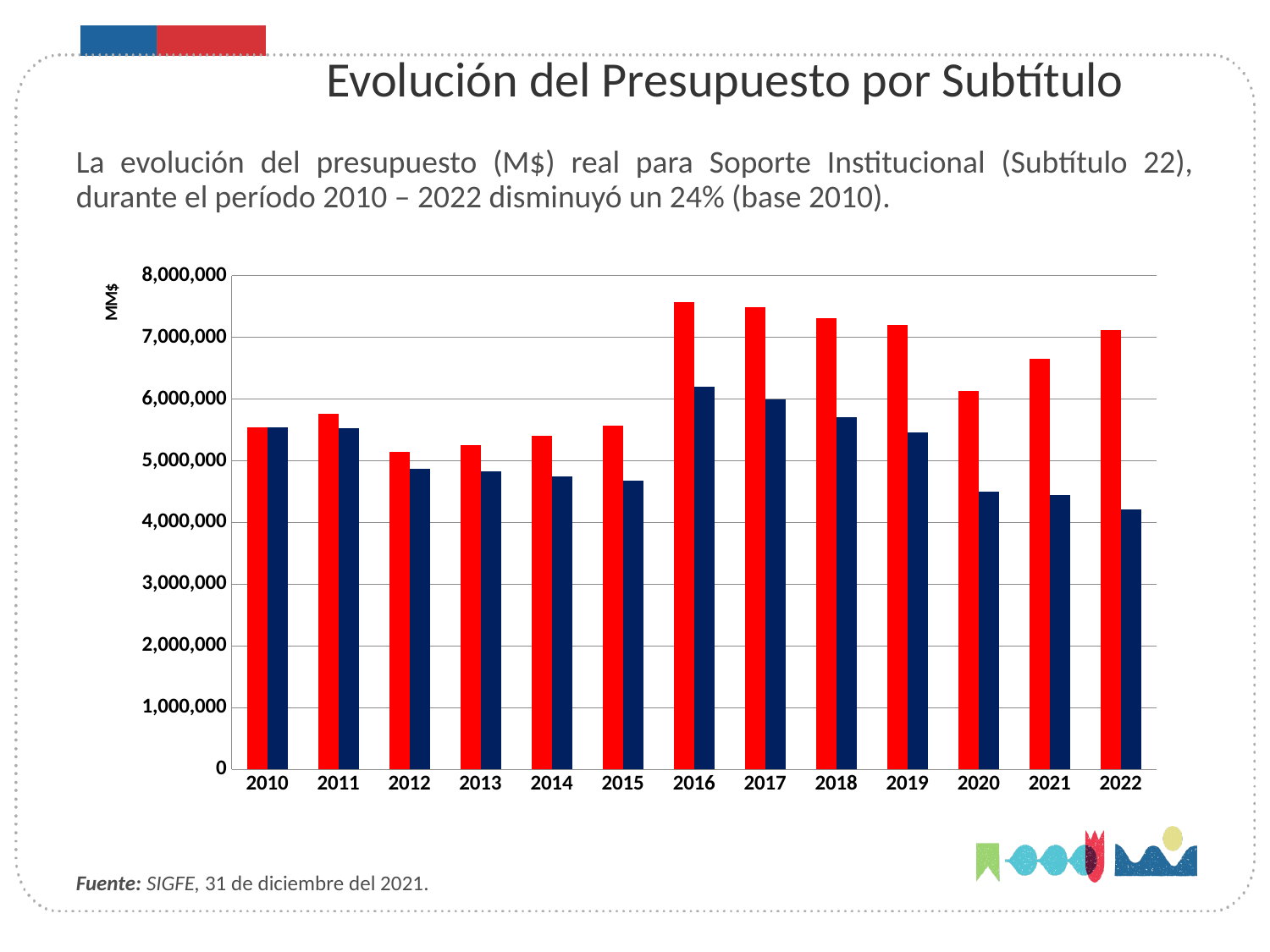
What is the label on the vertical axis of the chart? MM$ In which year is the dark blue bar the highest? 2016 Is the value of the dark blue bar for 2022 greater or less than 5,000,000? less Is the value of the dark blue bar for 2020 greater or less than 5,000,000? less What kind of chart is shown on the slide? bar chart How many years are shown on the x axis of the chart? 13 In which year is the dark blue bar the lowest? 2022 Is the value of the red bar for 2016 greater or less than 7,000,000? greater Which is larger, the red bar for 2010 or the red bar for 2016? 2016 What is the title of the slide containing the chart? Evolución del Presupuesto por Subtítulo